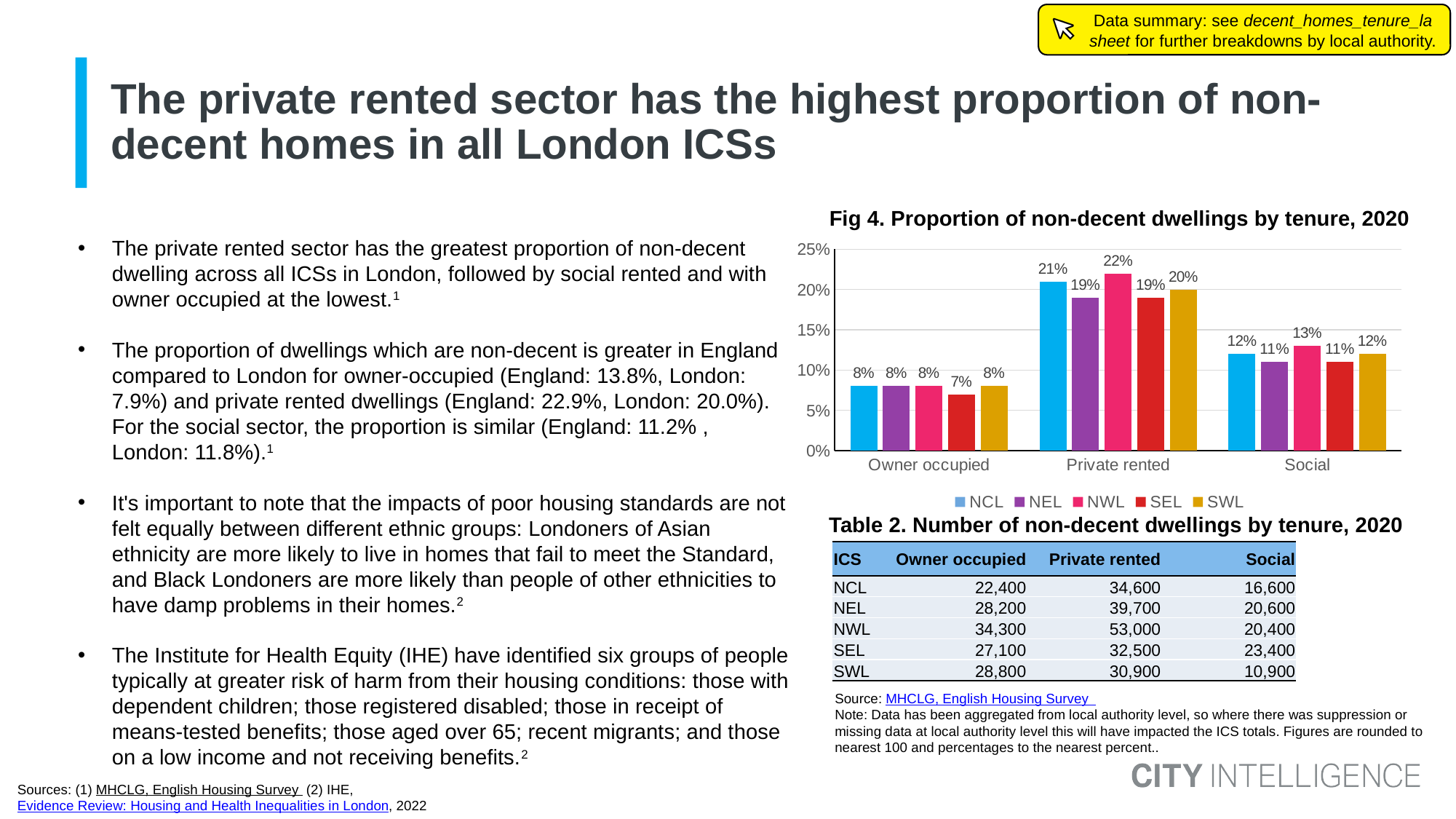
How many tenure categories are shown on the x axis of Fig 4? 3 In Fig 4, what is the proportion of non-decent dwellings for NWL in the Private rented tenure? 22% In Fig 4, which ICS has the highest proportion of non-decent dwellings in the Private rented tenure? NWL How many series does the legend of Fig 4 list? 5 In Fig 4, is the value for NWL in the Private rented tenure greater or less than 20%? greater What is the title of the chart on the slide? Fig 4. Proportion of non-decent dwellings by tenure, 2020 In Fig 4, what is the difference between the NWL and NEL values in the Private rented tenure? 3% What kind of chart is Fig 4? Bar chart In Fig 4, which ICS has the lowest proportion of non-decent dwellings in the Owner occupied tenure? SEL In Fig 4, what is the value for SEL in the Owner occupied tenure? 7% In Fig 4, which is larger: the NCL value for Private rented or the SWL value for Private rented? NCL value for Private rented In Fig 4, what is the value for NCL in the Social tenure? 12%